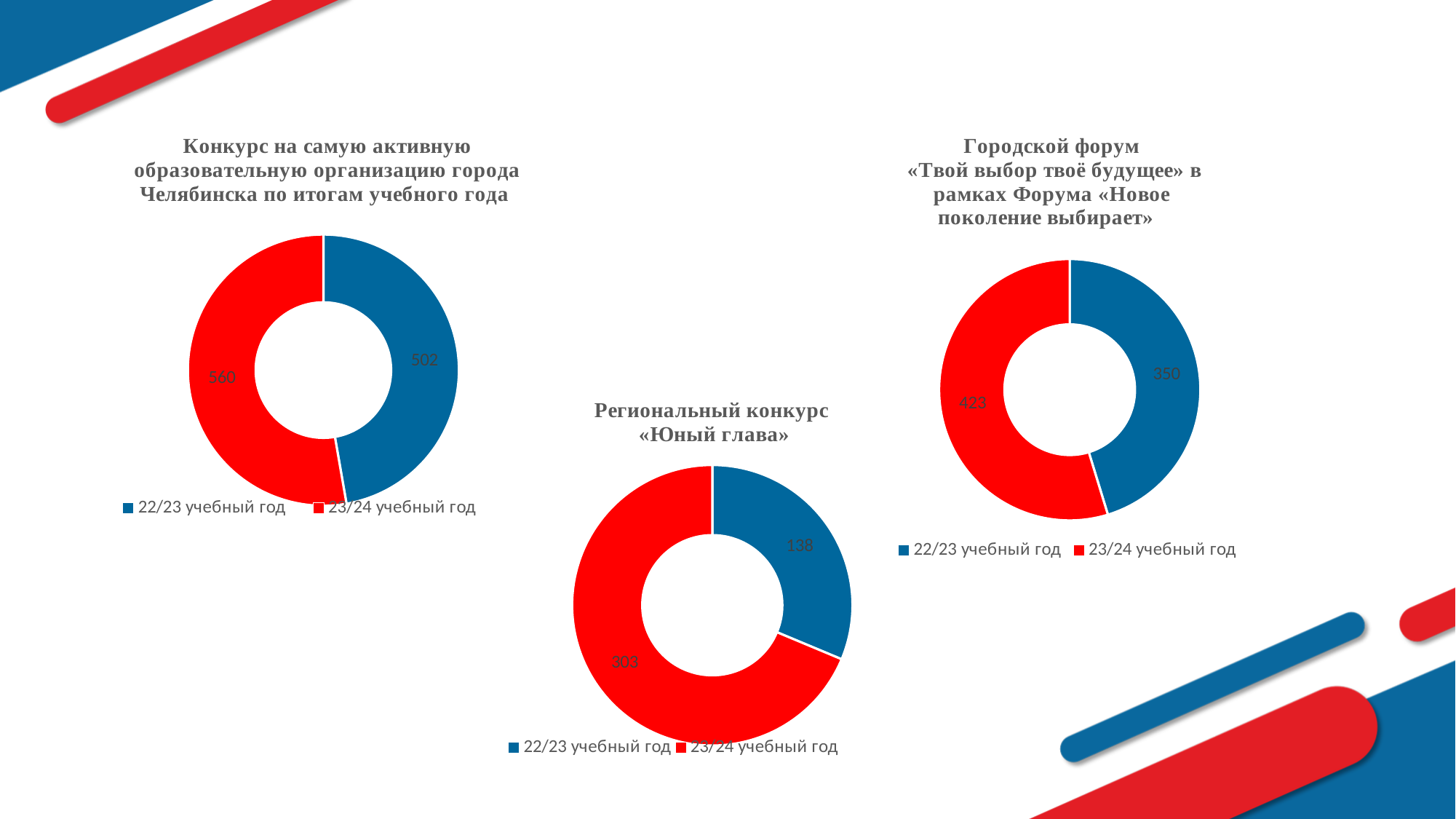
In the chart titled «Региональный конкурс «Юный глава»», which academic year has the smallest value? 22/23 учебный год In the right chart (Городской форум «Твой выбор твоё будущее»), what is the value for 22/23 учебный год? 350 What type of chart is used for «Региональный конкурс «Юный глава»»? Doughnut chart How many series does the legend of the right chart (Городской форум «Твой выбор твоё будущее») list? 2 In the left chart (Конкурс на самую активную образовательную организацию города Челябинска), what is the value for 22/23 учебный год? 502 In the chart titled «Региональный конкурс «Юный глава»», what is the value for 22/23 учебный год? 138 In the left chart (Конкурс на самую активную образовательную организацию города Челябинска), which academic year has the larger value? 23/24 учебный год In the chart titled «Региональный конкурс «Юный глава»», what is the difference between the 23/24 and 22/23 values? 165 In the left chart (Конкурс на самую активную образовательную организацию города Челябинска), what is the value for 23/24 учебный год? 560 In the right chart (Городской форум «Твой выбор твоё будущее»), what is the difference between the 23/24 and 22/23 values? 73 In the right chart (Городской форум «Твой выбор твоё будущее»), what is the value for 23/24 учебный год? 423 In the chart titled «Региональный конкурс «Юный глава»», what is the value for 23/24 учебный год? 303